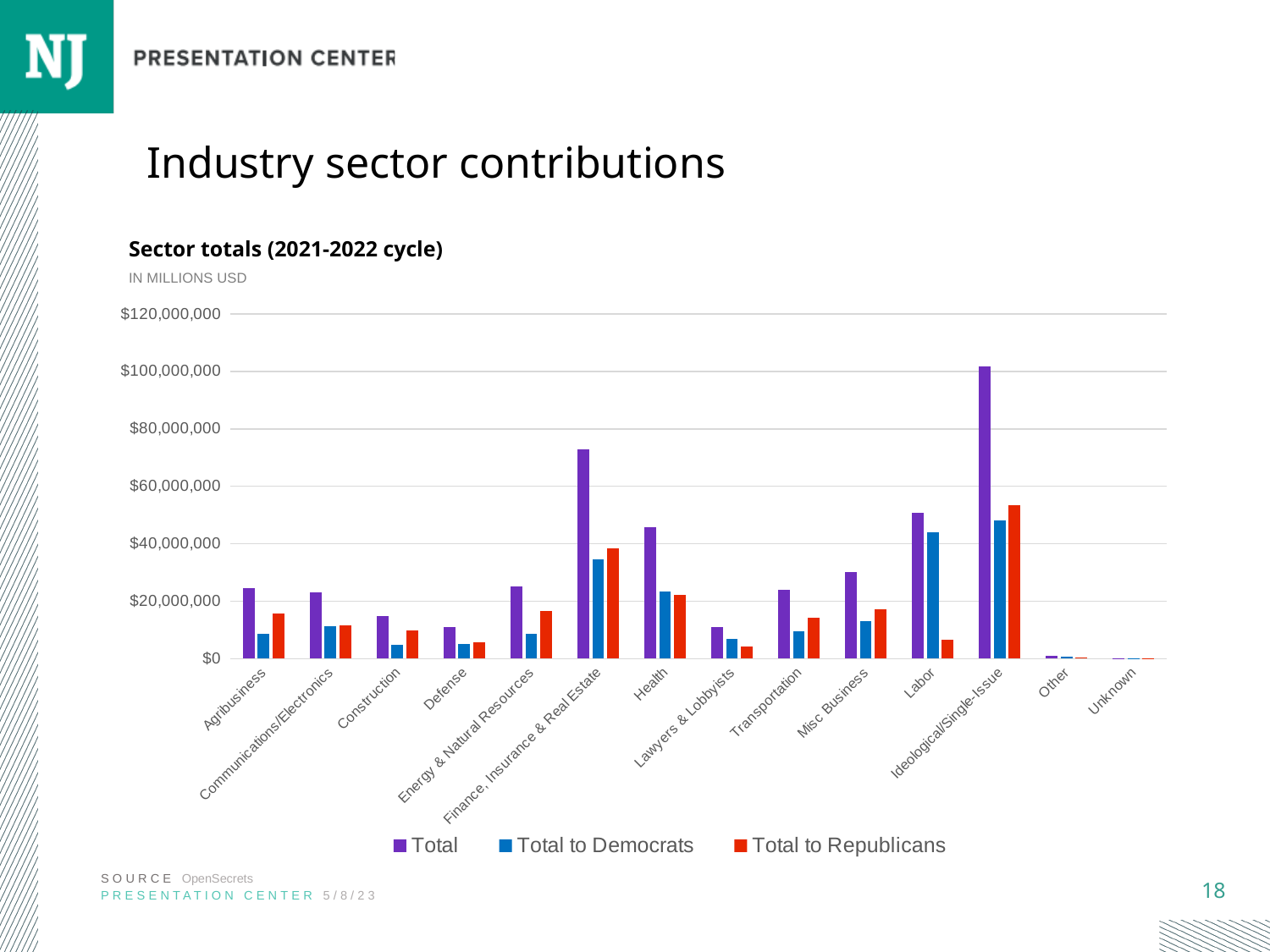
For Agribusiness, which is larger: Total to Democrats or Total to Republicans? Total to Republicans Is the Total value for Ideological/Single-Issue greater or less than $80,000,000? greater Is the Total value for Finance, Insurance & Real Estate greater or less than $60,000,000? greater For Labor, which is larger: Total to Democrats or Total to Republicans? Total to Democrats How many series does the legend list? 3 Which sector has the highest Total contribution? Ideological/Single-Issue What kind of chart is shown on the slide? bar chart Is the Total value for Health greater or less than $40,000,000? greater What is the title of the chart? Sector totals (2021-2022 cycle) How many industry sector categories are shown on the x axis? 14 Which colour represents the Total to Democrats series? blue